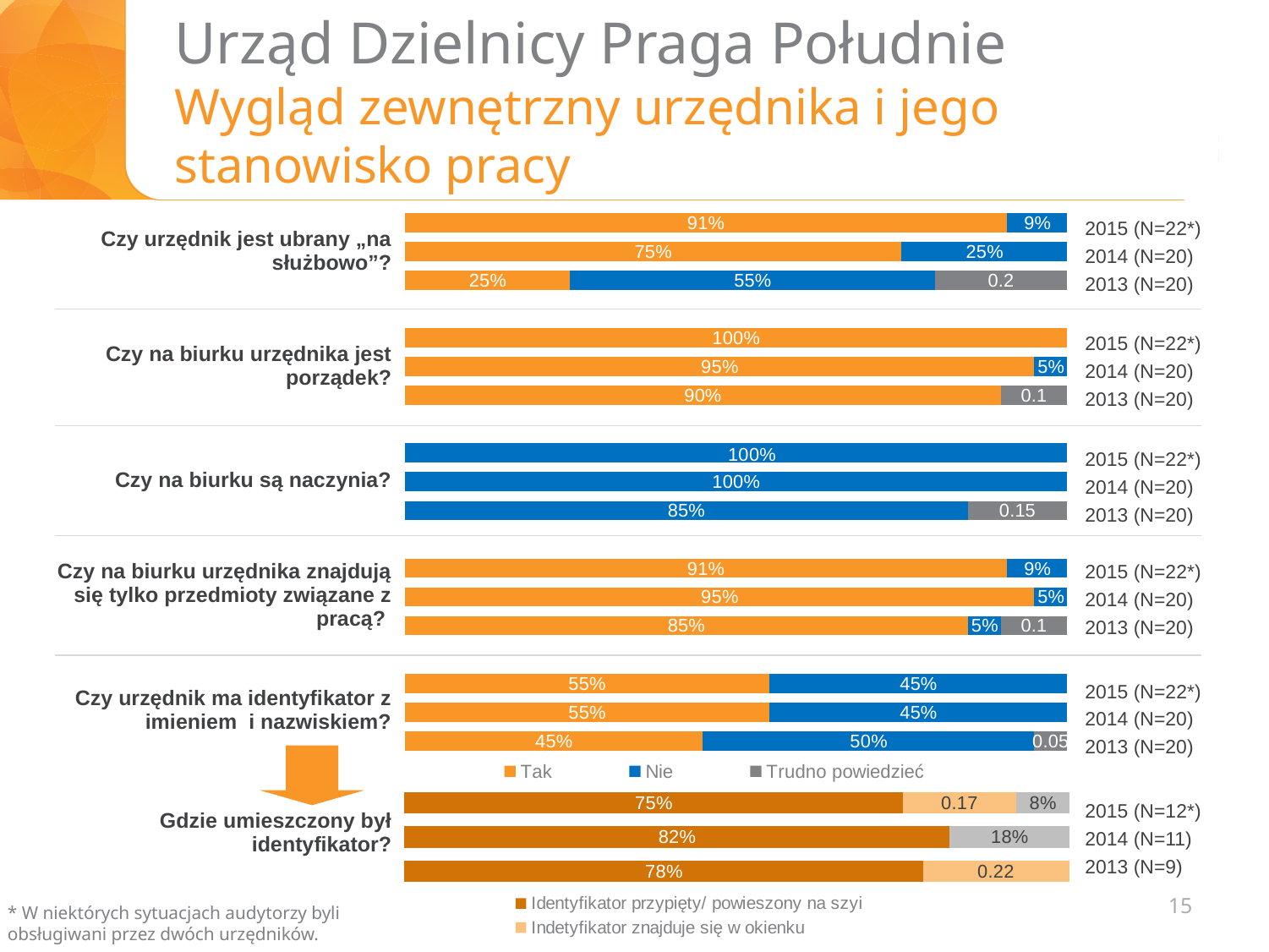
In the chart "Gdzie umieszczony był identyfikator?", what is the value for "Indetyfikator znajduje się w okienku" in 2013 (N=9)? 0.22 In the chart "Czy na biurku urzędnika jest porządek?", what is the difference between the "Tak" values for 2015 (N=22*) and 2014 (N=20)? 5% In the chart "Czy na biurku urzędnika znajdują się tylko przedmioty związane z pracą?", what is the "Tak" value for 2014 (N=20)? 95% In the chart "Czy na biurku urzędnika jest porządek?", what is the "Tak" value for 2013 (N=20)? 90% How many entries does the legend of the chart "Czy urzędnik ma identyfikator z imieniem i nazwiskiem?" list? 3 In the chart "Czy urzędnik jest ubrany „na służbowo”?", what is the "Tak" value for 2015 (N=22*)? 91% In the chart "Gdzie umieszczony był identyfikator?", what is the value for "Identyfikator przypięty/ powieszony na szyi" in 2014 (N=11)? 82% In the chart "Czy urzędnik ma identyfikator z imieniem i nazwiskiem?", what is the "Tak" value for 2015 (N=22*)? 55% In the chart "Czy na biurku są naczynia?", what is the "Trudno powiedzieć" value for 2013 (N=20)? 0.15 In the chart "Czy urzędnik jest ubrany „na służbowo”?", which year has the highest "Tak" value? 2015 (N=22*) In the chart "Czy urzędnik jest ubrany „na służbowo”?", what is the "Nie" value for 2013 (N=20)? 55% In the chart "Czy urzędnik ma identyfikator z imieniem i nazwiskiem?", which is larger for 2013 (N=20): the "Tak" value or the "Nie" value? Nie